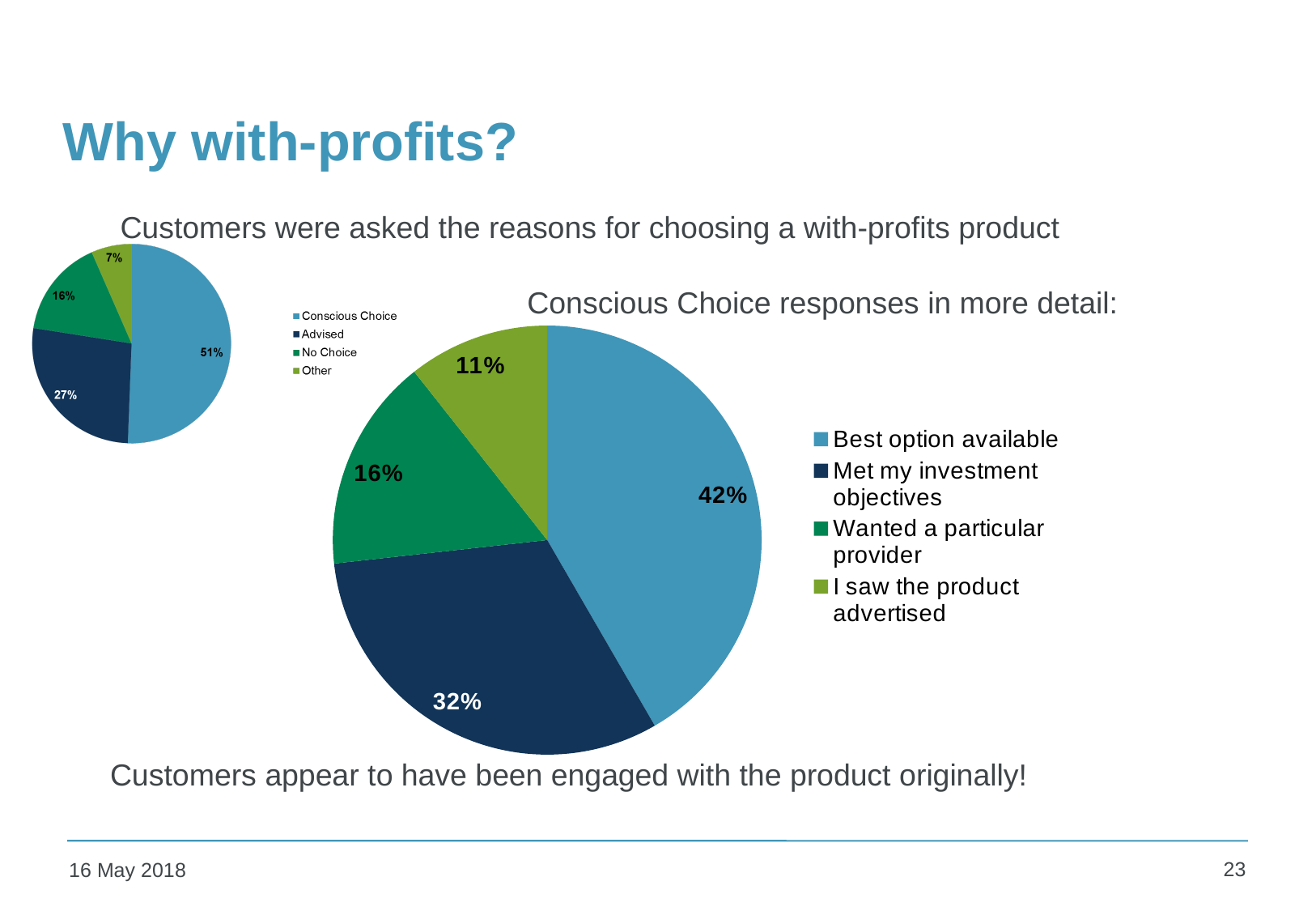
In the large pie chart (Conscious Choice responses in more detail), what is the difference in percentage points between 'Best option available' and 'Met my investment objectives'? 10 percentage points In the small pie chart at the top left of the slide, which category has the smallest slice? Other In the large pie chart (Conscious Choice responses in more detail), what share is labelled for 'Best option available'? 42% What type of chart is the large chart titled 'Conscious Choice responses in more detail'? Pie chart In the large pie chart (Conscious Choice responses in more detail), which category has the smallest slice? I saw the product advertised In the large pie chart (Conscious Choice responses in more detail), what share is labelled for 'I saw the product advertised'? 11% In the small pie chart at the top left of the slide, which is larger: 'No Choice' or 'Other'? No Choice In the large pie chart (Conscious Choice responses in more detail), what share is labelled for 'Met my investment objectives'? 32% In the large pie chart (Conscious Choice responses in more detail), which category has the largest slice? Best option available In the small pie chart at the top left of the slide, what share is labelled for 'Conscious Choice'? 51% In the large pie chart (Conscious Choice responses in more detail), how many categories does the legend list? 4 In the small pie chart at the top left of the slide, what share is labelled for 'Advised'? 27%